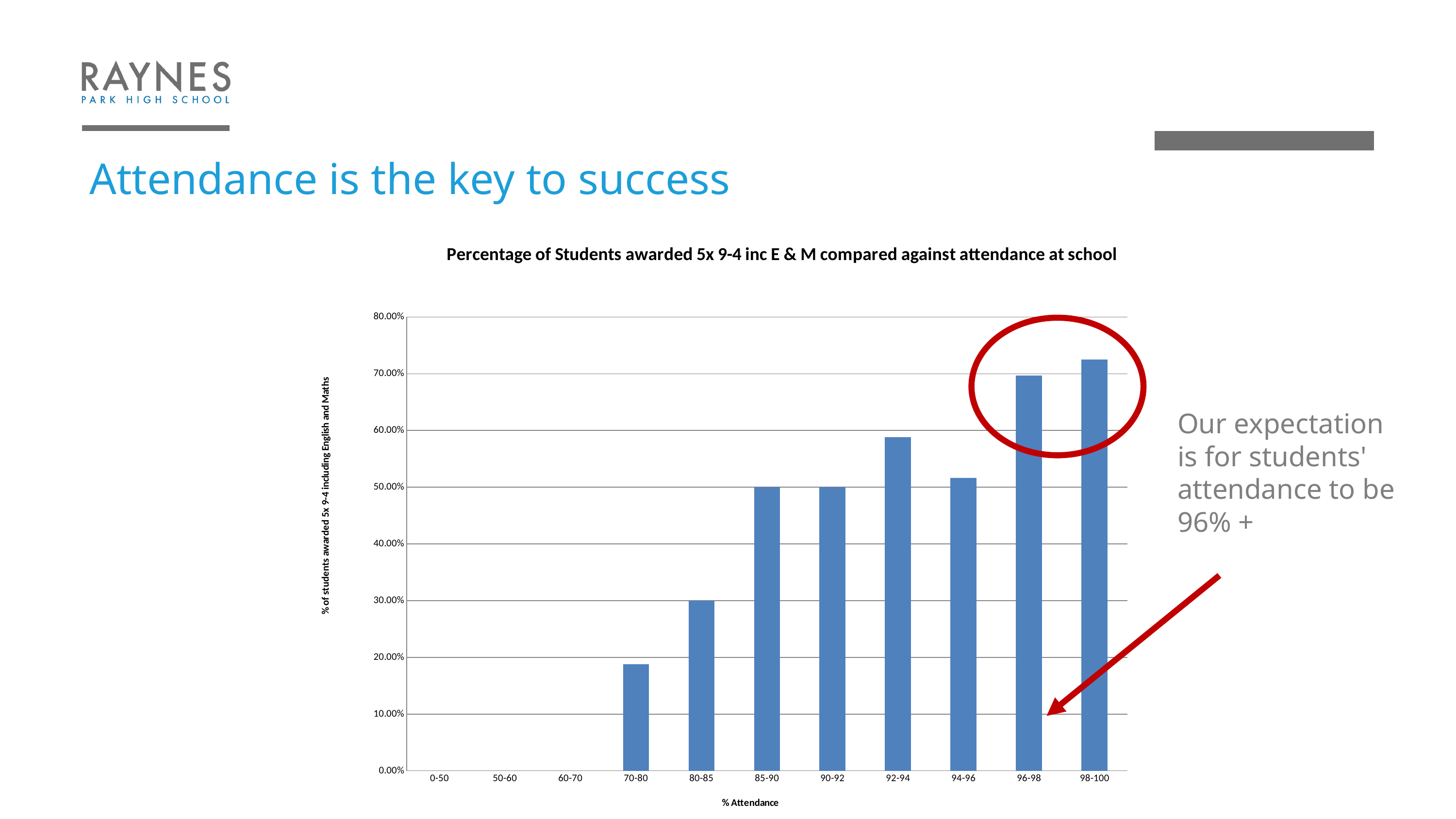
What is the value for the 85-90 attendance category? 50.00% How many attendance categories are shown on the x axis? 11 What is the value for the 80-85 attendance category? 30.00% Is the value for the 70-80 attendance category greater or less than 20.00%? less Is the value for the 98-100 attendance category greater or less than 70.00%? greater What is the label of the x axis of the chart? % Attendance What kind of chart is shown on the slide? bar chart Do the values generally rise or fall as attendance increases along the x axis? rise What is the title of the chart? Percentage of Students awarded 5x 9-4 inc E & M compared against attendance at school Which attendance category has the lowest non-zero bar? 70-80 Which has the larger value, the 92-94 category or the 94-96 category? 92-94 Which attendance category has the highest bar? 98-100